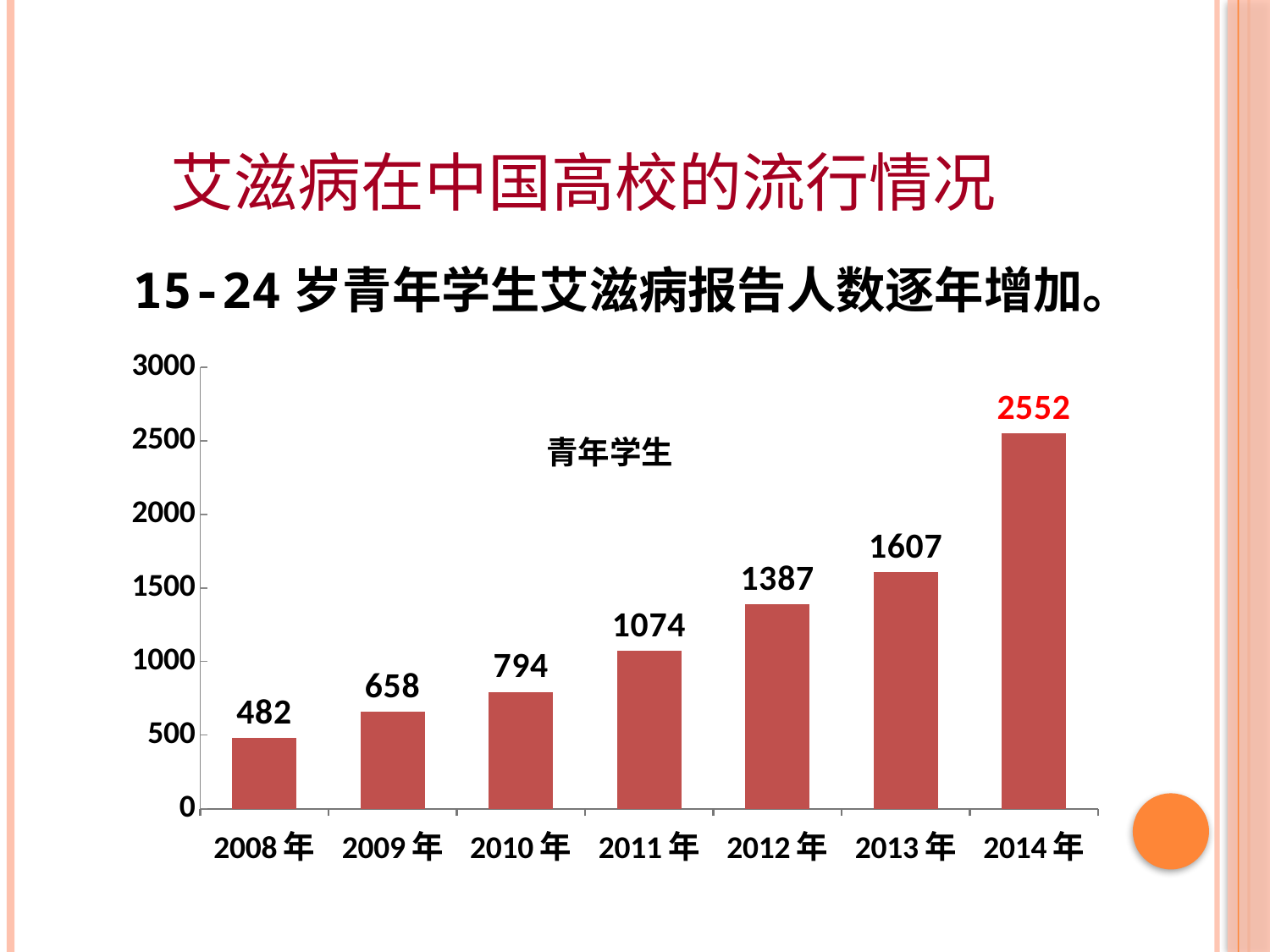
Do the values rise or fall from 2008年 to 2014年? rise What is the difference between the values for 2014年 and 2013年? 945 Which year has the highest value? 2014年 Is the value for 2012年 greater or less than 1500? less Which year has the lowest value? 2008年 What is the value for 2011年? 1074 How many years are shown on the x axis? 7 What kind of chart is shown on the slide? bar chart What is the difference between the values for 2010年 and 2009年? 136 What is the value for 2013年? 1607 What is the value for 2008年? 482 Which is larger, the value for 2012年 or the value for 2011年? 2012年